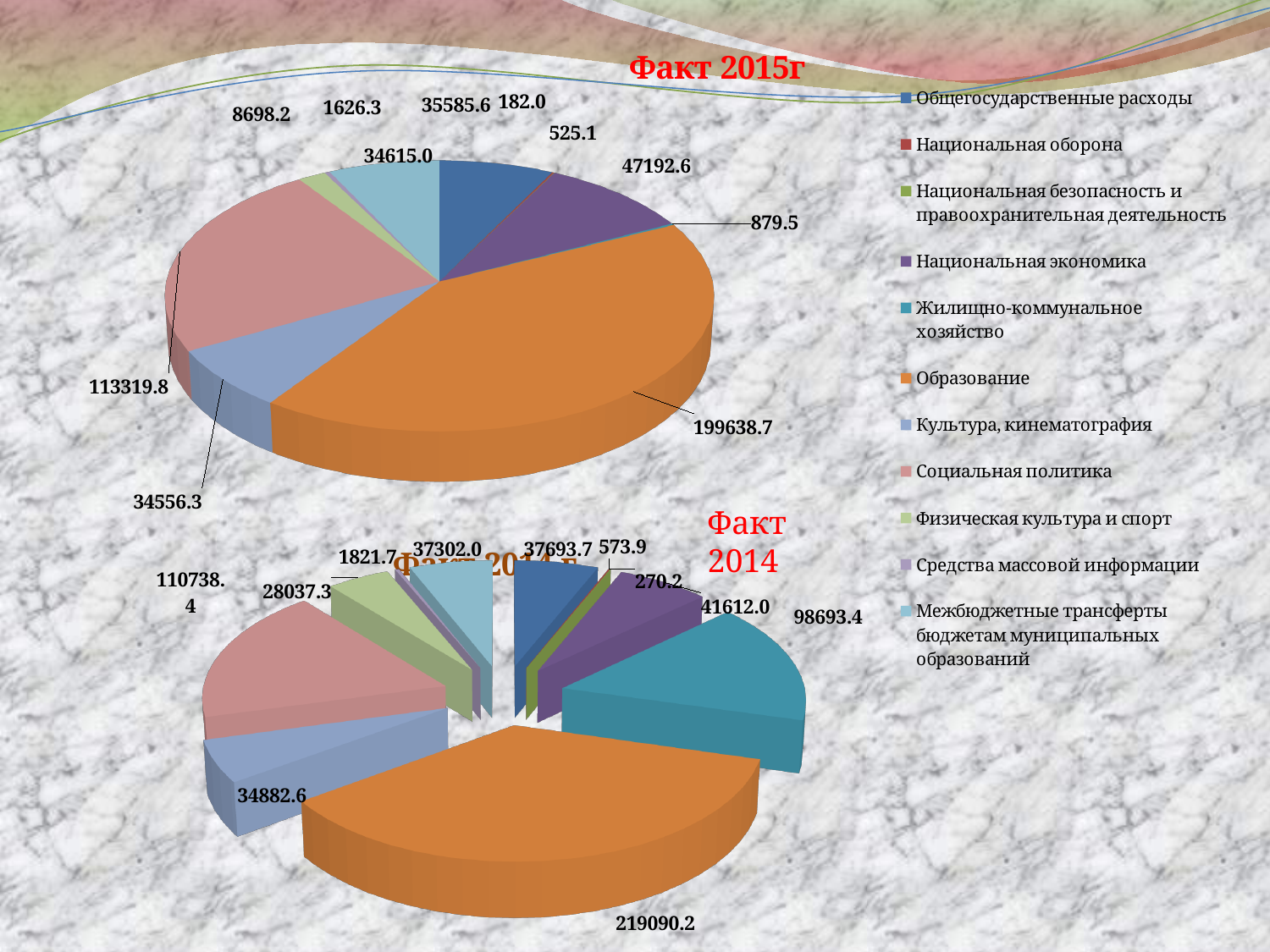
In the 'Факт 2015г' chart, what is the value for Образование? 199638.7 In the 'Факт 2014 г' chart, what is the value for Образование? 219090.2 What is the difference between the Образование value in the 'Факт 2014 г' chart and in the 'Факт 2015г' chart? 19451.5 In the 'Факт 2015г' chart, which category has the largest slice? Образование What colour represents Образование in the charts? Orange In the 'Факт 2015г' chart, what is the value for Социальная политика? 113319.8 In the 'Факт 2014 г' chart, what is the value for Жилищно-коммунальное хозяйство? 98693.4 In the 'Факт 2014 г' chart, which category has the largest slice? Образование How many categories does the legend list? 11 In the 'Факт 2015г' chart, which category has the smallest value? Национальная безопасность и правоохранительная деятельность In the 'Факт 2015г' chart, which is larger: Национальная экономика or Общегосударственные расходы? Национальная экономика What type of charts are shown on the slide? Pie charts